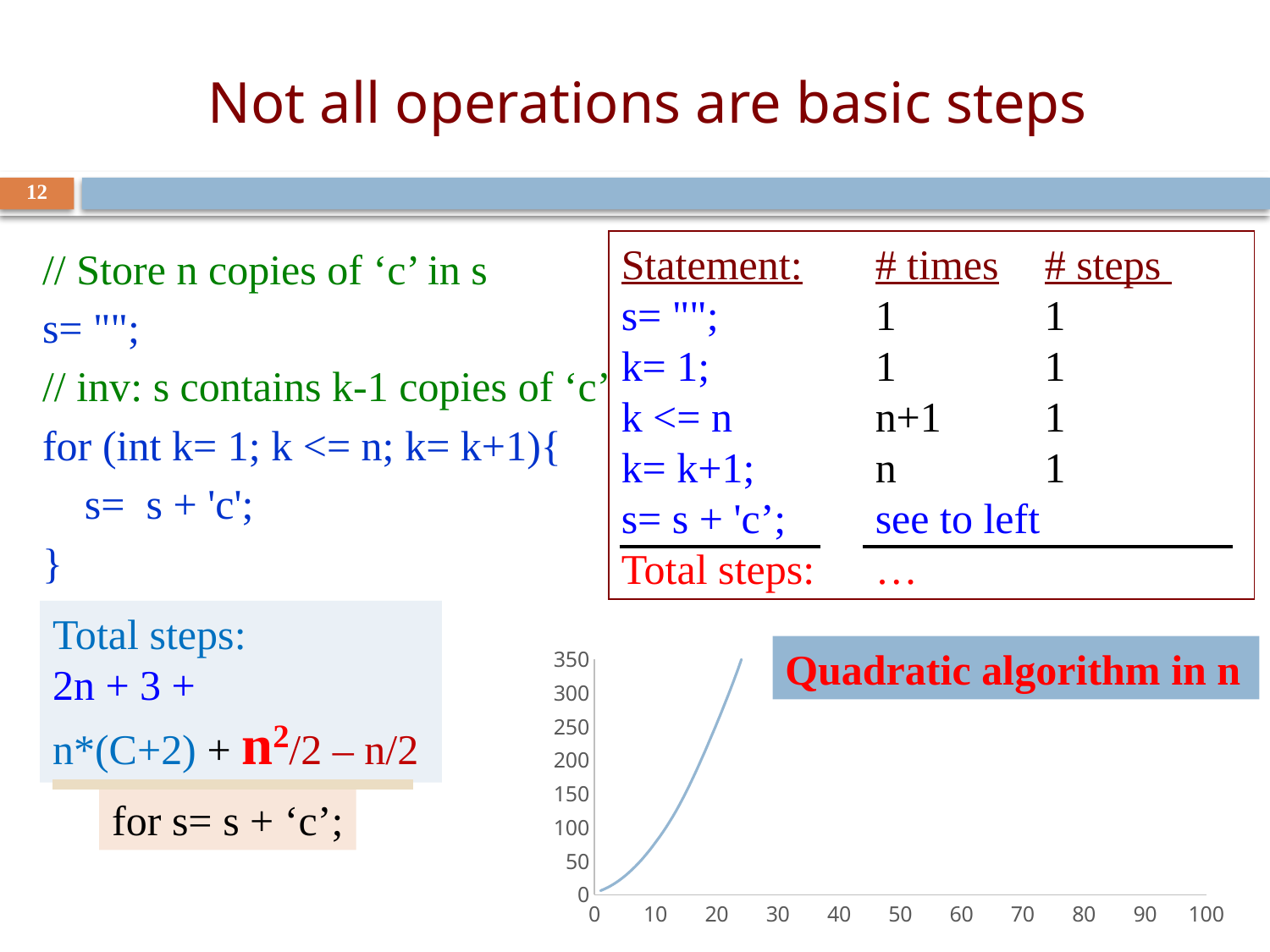
What is the highest tick value shown on the chart's y axis? 350 Is the value on the chart at x = 20 greater or less than 100? greater What is the highest tick value shown on the chart's x axis? 100 What kind of chart is shown at the bottom right of the slide? line chart Do the values on the chart rise or fall as x increases from 0? rise Is the value on the chart at x = 10 greater or less than 150? less Is the value on the chart at x = 5 greater or less than 50? less Does the line on the chart rise at an increasing rate or at a constant rate? increasing rate